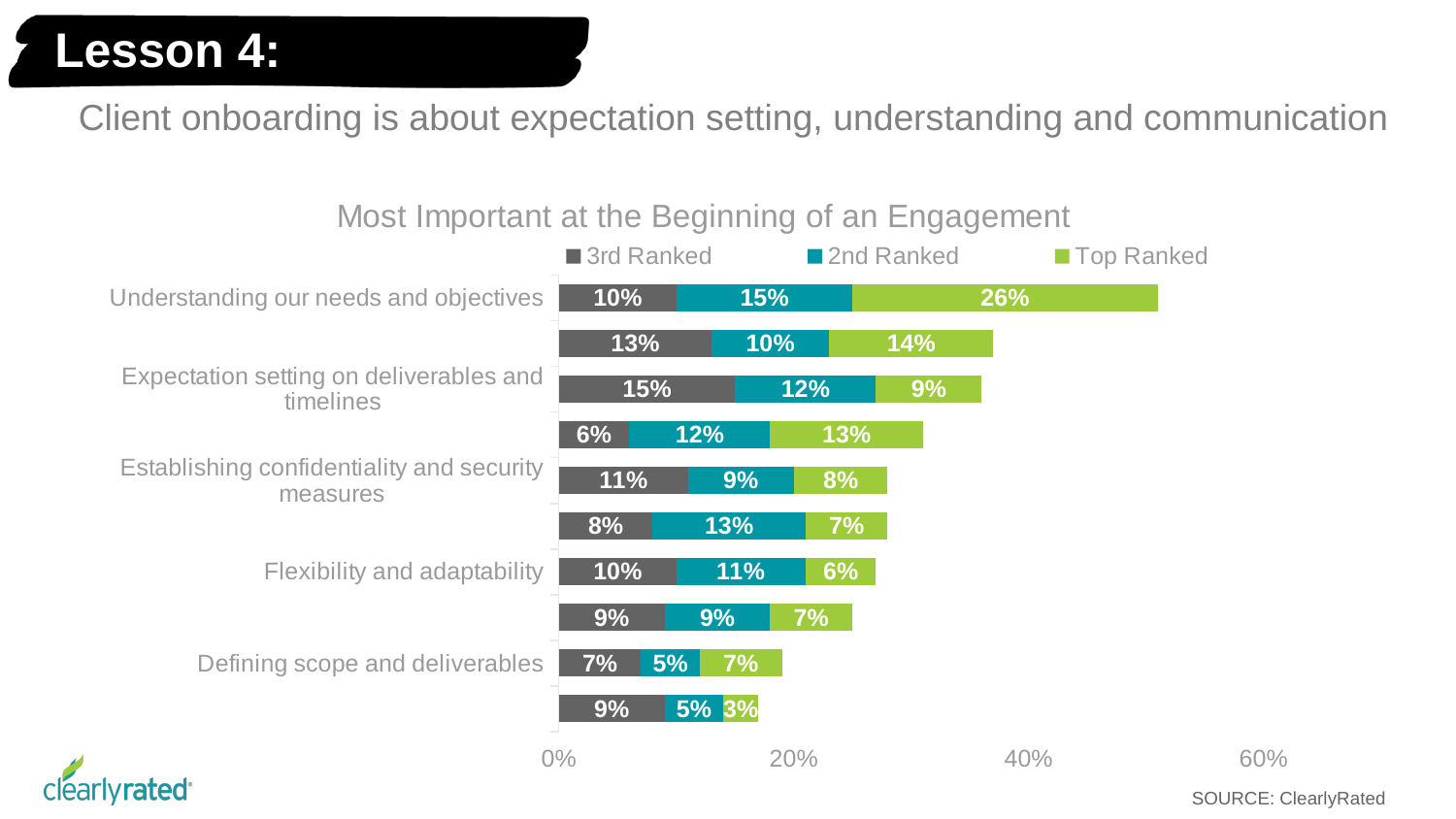
What is the 2nd Ranked value for Flexibility and adaptability? 11% Which labeled category has the highest Top Ranked value? Understanding our needs and objectives What is the difference between the Top Ranked values for Understanding our needs and objectives and Expectation setting on deliverables and timelines? 17% What is the total of the stacked bar for Defining scope and deliverables? 19% How many series does the legend list? 3 What is the 3rd Ranked value for Expectation setting on deliverables and timelines? 15% What is the title of the chart? Most Important at the Beginning of an Engagement Which is larger: the 3rd Ranked value for Expectation setting on deliverables and timelines or the 3rd Ranked value for Flexibility and adaptability? Expectation setting on deliverables and timelines What is the Top Ranked value for Understanding our needs and objectives? 26% What is the total of the stacked bar for Understanding our needs and objectives? 51% What is the Top Ranked value for Defining scope and deliverables? 7% What is the 2nd Ranked value for Establishing confidentiality and security measures? 9%